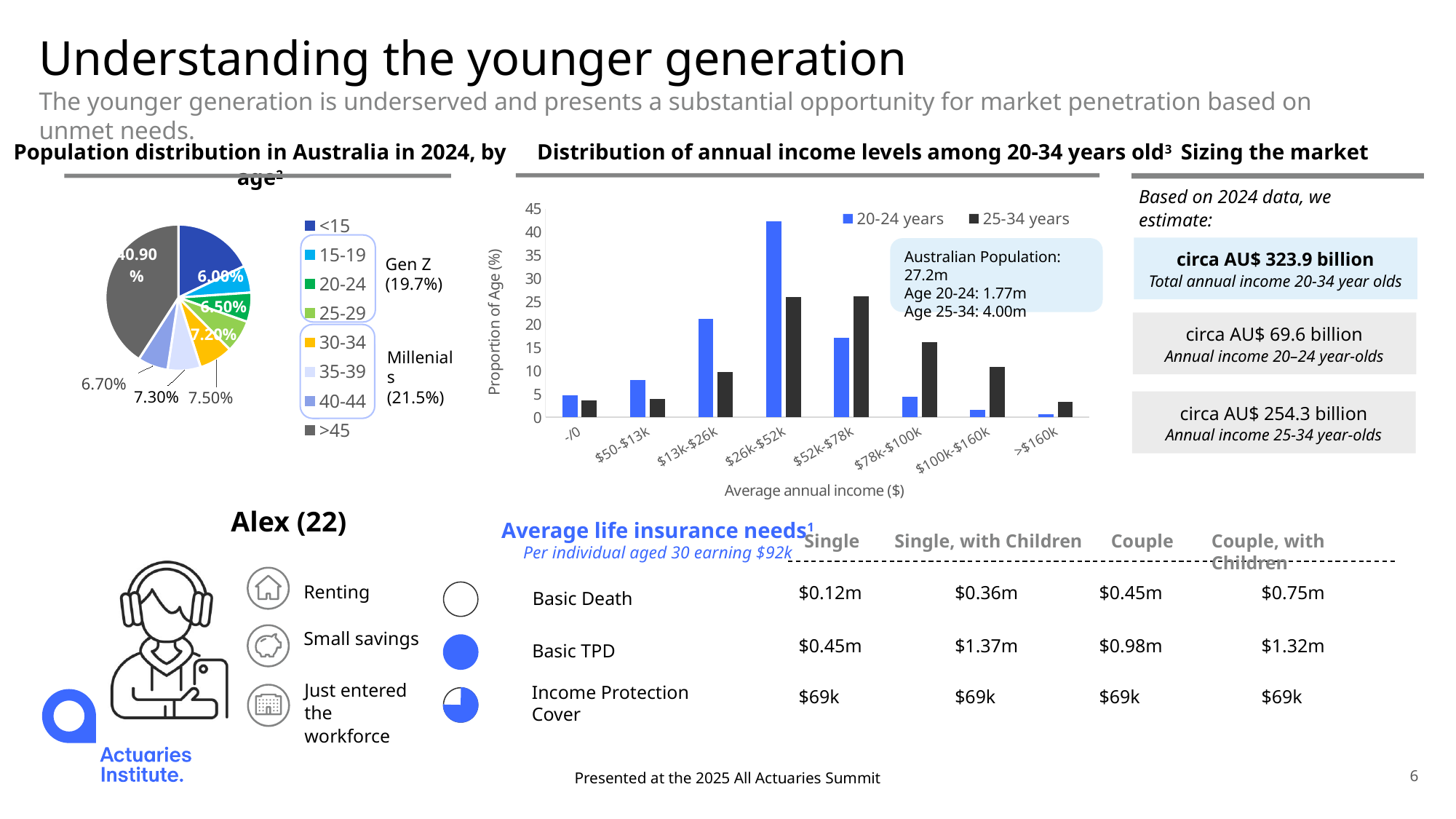
What type of chart is the 'Population distribution in Australia in 2024, by age' chart? Pie chart How many series does the legend of the 'Distribution of annual income levels among 20-34 years old' chart list? 2 According to the 'Population distribution in Australia in 2024, by age' chart, what share of the population is Gen Z? 19.7% How many income categories are shown on the x axis of the 'Distribution of annual income levels among 20-34 years old' chart? 8 In the 'Population distribution in Australia in 2024, by age' pie chart, what share of the population is aged >45? 40.90% How many age categories does the legend of the 'Population distribution in Australia in 2024, by age' pie chart list? 8 In the 'Population distribution in Australia in 2024, by age' pie chart, which age group has the largest slice? >45 In the 'Distribution of annual income levels among 20-34 years old' chart, which income category has the highest bar for 20-24 years? $26k-$52k In the 'Distribution of annual income levels among 20-34 years old' chart, which series has the larger value in the $78k-$100k category, 20-24 years or 25-34 years? 25-34 years In the 'Distribution of annual income levels among 20-34 years old' chart, is the value for 20-24 years in the $26k-$52k category greater or less than 40? greater According to the 'Population distribution in Australia in 2024, by age' chart, what share of the population is Millennials? 21.5% What type of chart is the 'Distribution of annual income levels among 20-34 years old' chart? Bar chart